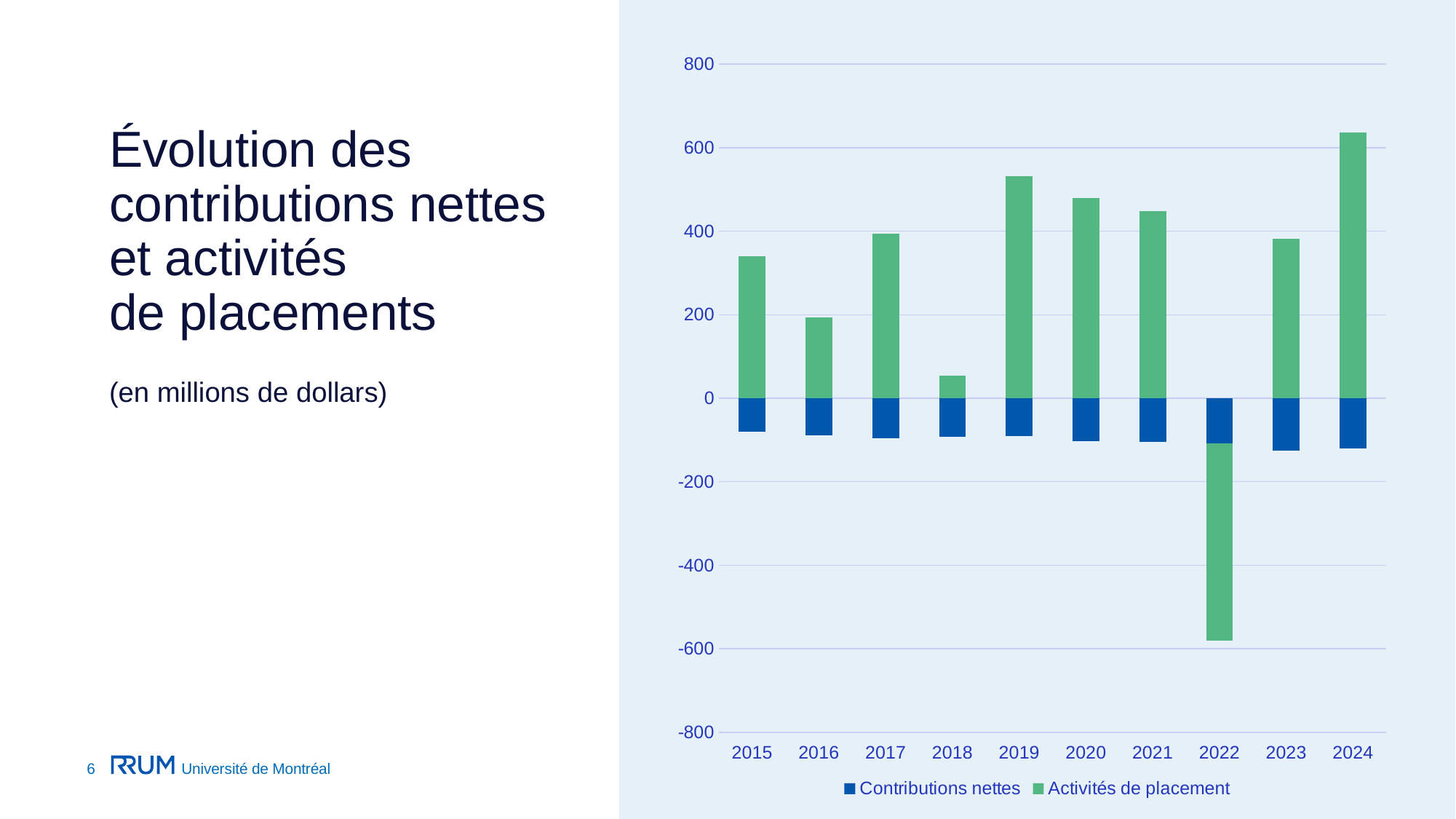
Which year has the highest value for Activités de placement? 2024 Is the value for Activités de placement in 2022 greater or less than -400? less Which is larger, the Activités de placement value for 2019 or for 2020? 2019 Which is larger, the Activités de placement value for 2015 or for 2016? 2015 Is the value for Activités de placement in 2019 greater or less than 400? greater Is the value for Activités de placement in 2024 greater or less than 600? greater What kind of chart is shown on the slide? bar chart Which colour represents Contributions nettes in the legend? blue How many years are shown on the x axis? 10 Which year has the lowest value for Activités de placement? 2022 How many series does the legend list? 2